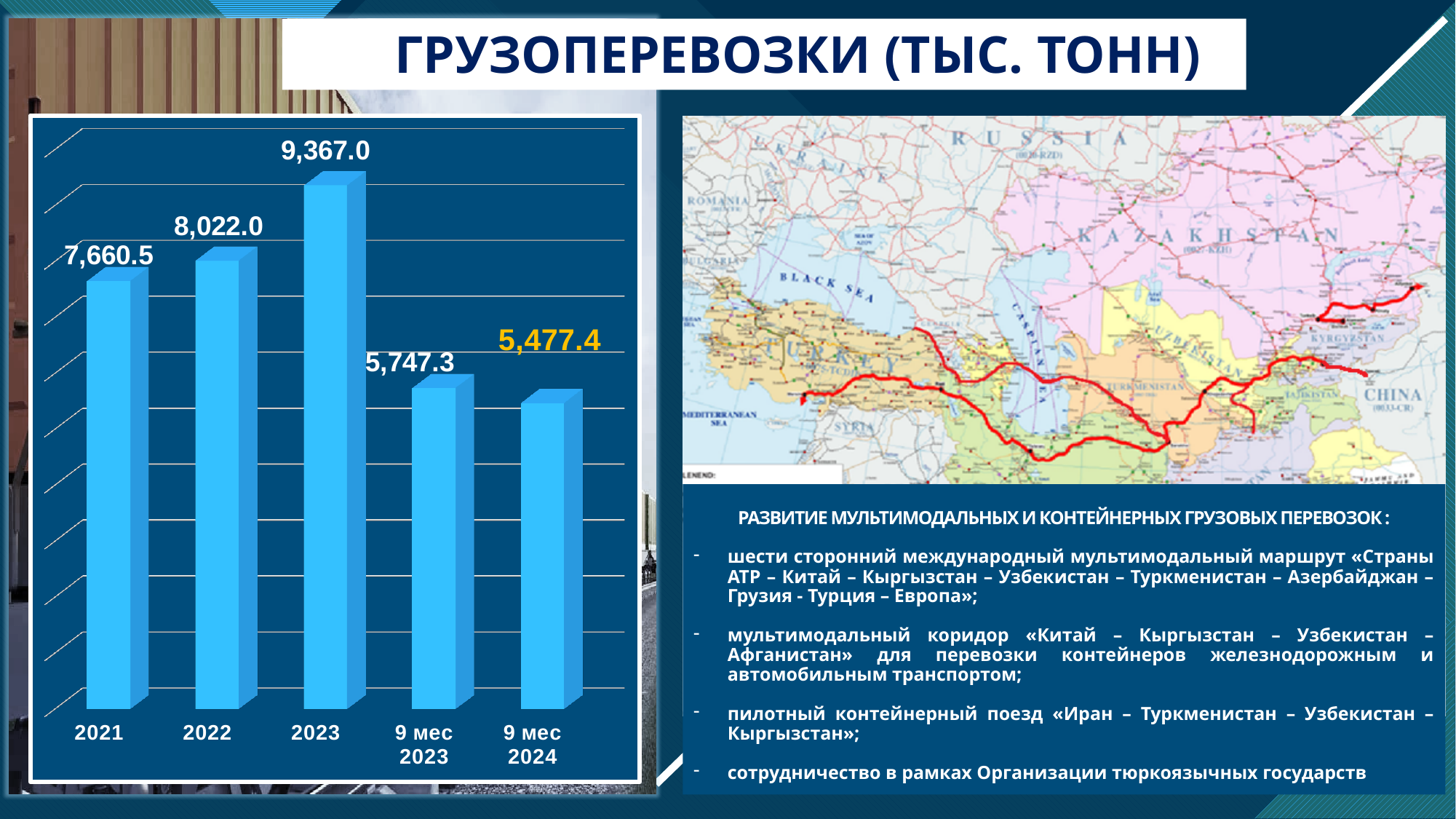
What is the difference between the values for 2023 and 2022? 1,345.0 Which category has the highest value? 2023 What is the difference between the values for 9 мес 2023 and 9 мес 2024? 269.9 Which category has the lowest value? 9 мес 2024 What is the value for 2022? 8,022.0 What is the title of the chart? ГРУЗОПЕРЕВОЗКИ (ТЫС. ТОНН) What is the value for 2021? 7,660.5 Which is larger, the value for 2021 or the value for 2022? 2022 How many bars are shown in the chart? 5 What is the value for 9 мес 2024? 5,477.4 What kind of chart is shown on the slide? bar chart What is the value for 2023? 9,367.0